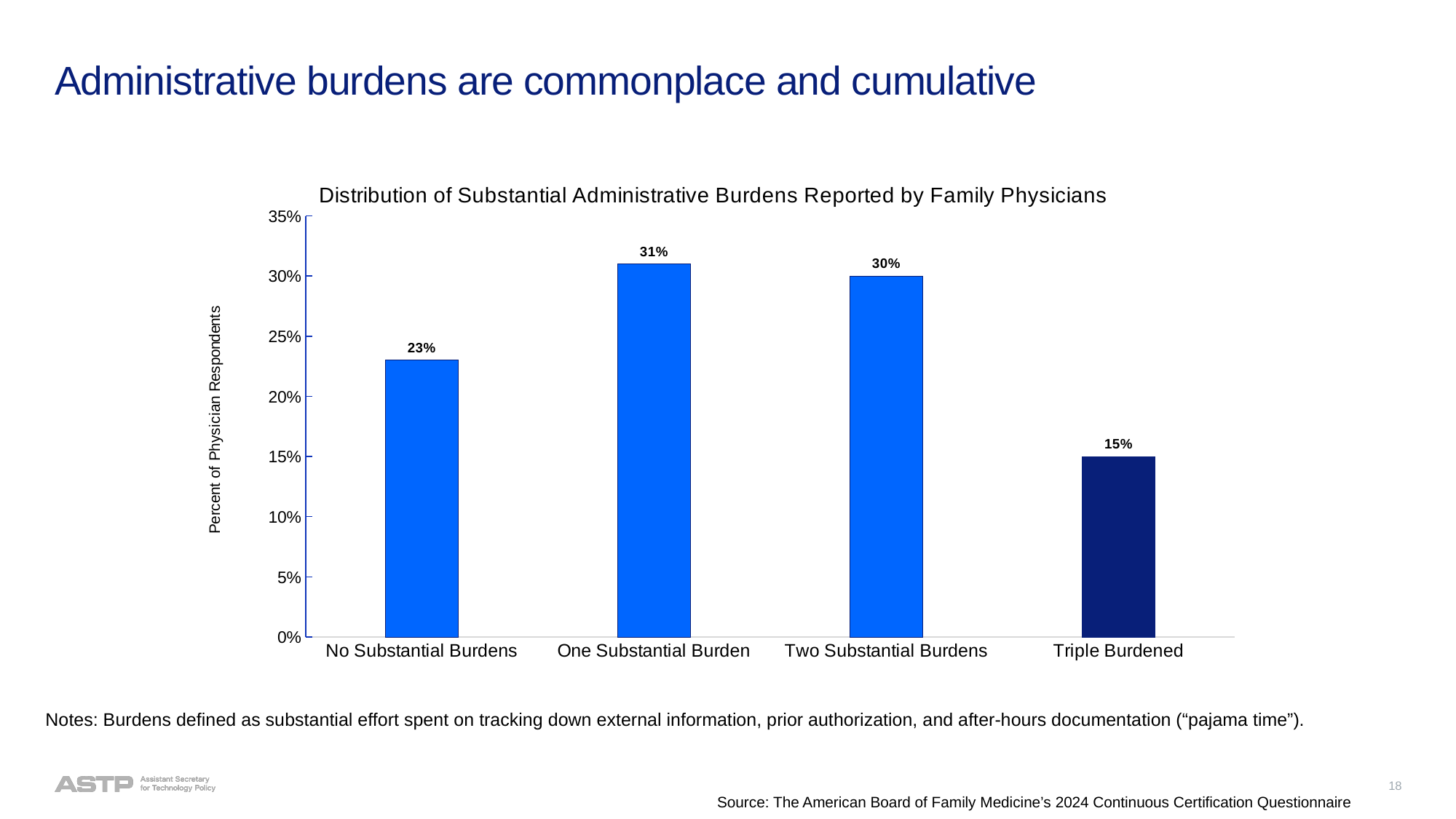
What is the difference between the values for One Substantial Burden and Triple Burdened? 16% Which category has the highest value? One Substantial Burden What kind of chart is shown on the slide? Bar chart Which bar is shown in a darker blue than the others? Triple Burdened What percentage of respondents reported Two Substantial Burdens? 30% What is the difference between the values for Two Substantial Burdens and No Substantial Burdens? 7% What percentage of physician respondents reported No Substantial Burdens? 23% How many categories are shown on the x axis? 4 What is the title of the chart? Distribution of Substantial Administrative Burdens Reported by Family Physicians What is the value for Triple Burdened? 15% Which category has the lowest value? Triple Burdened Which is larger, the value for No Substantial Burdens or the value for Triple Burdened? No Substantial Burdens